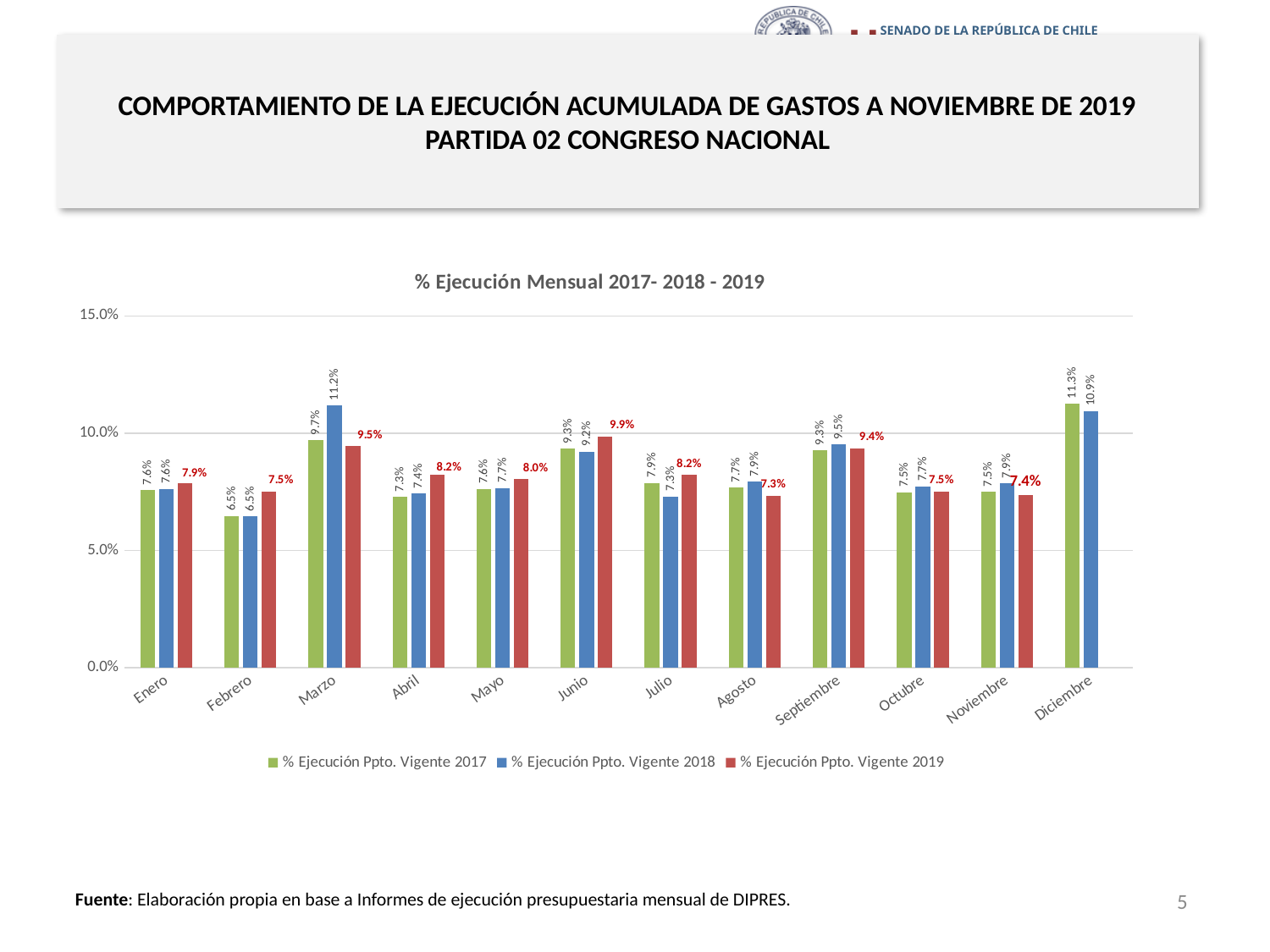
How many months are shown on the x axis? 12 What is the title of the chart? % Ejecución Mensual 2017- 2018 - 2019 What is the difference between the 2018 and 2017 values in Marzo? 1.5% Which month has the lowest value for % Ejecución Ppto. Vigente 2017? Febrero What kind of chart is shown on the slide? Bar chart What is the value for % Ejecución Ppto. Vigente 2017 in Diciembre? 11.3% In Julio, which is larger: the 2017 value or the 2018 value? 2017 How many series does the legend list? 3 What is the value for % Ejecución Ppto. Vigente 2019 in Junio? 9.9% Which month has the highest value for % Ejecución Ppto. Vigente 2019? Junio What is the value for % Ejecución Ppto. Vigente 2018 in Marzo? 11.2% Is the value for % Ejecución Ppto. Vigente 2018 in Diciembre greater or less than 10.0%? greater